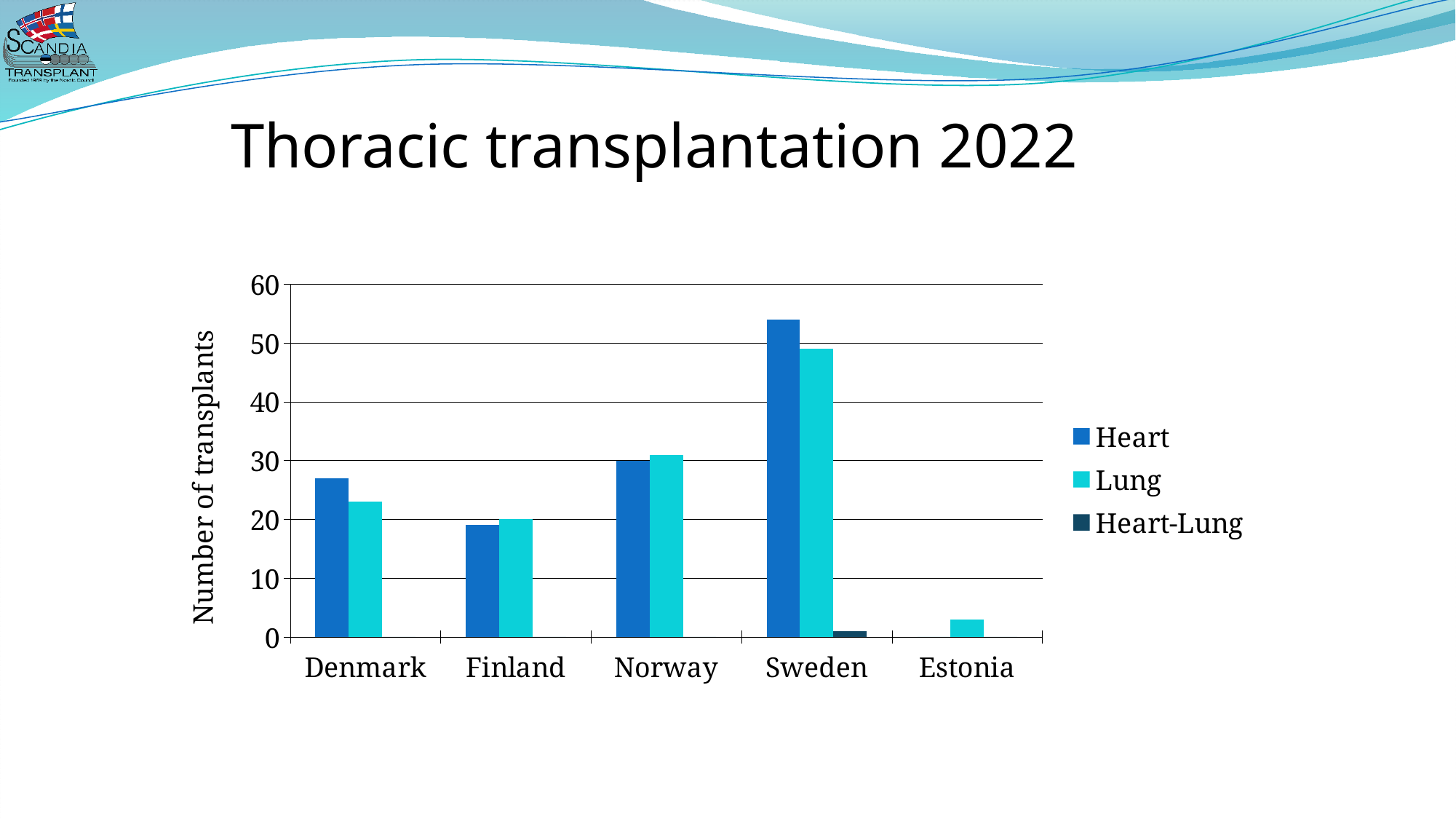
For Denmark, which is larger, the Heart value or the Lung value? Heart Which country has the highest Heart value? Sweden How many countries are shown on the x axis? 5 Is the Heart value for Finland greater or less than 20? less Is the Heart value for Sweden greater or less than 50? greater How many series does the legend list? 3 What is the label on the vertical axis of the chart? Number of transplants For Sweden, which is larger, the Heart value or the Lung value? Heart Which country has the lowest Lung value? Estonia Which country has the highest Lung value? Sweden What kind of chart is shown on the slide? bar chart Is the Lung value for Estonia greater or less than 10? less